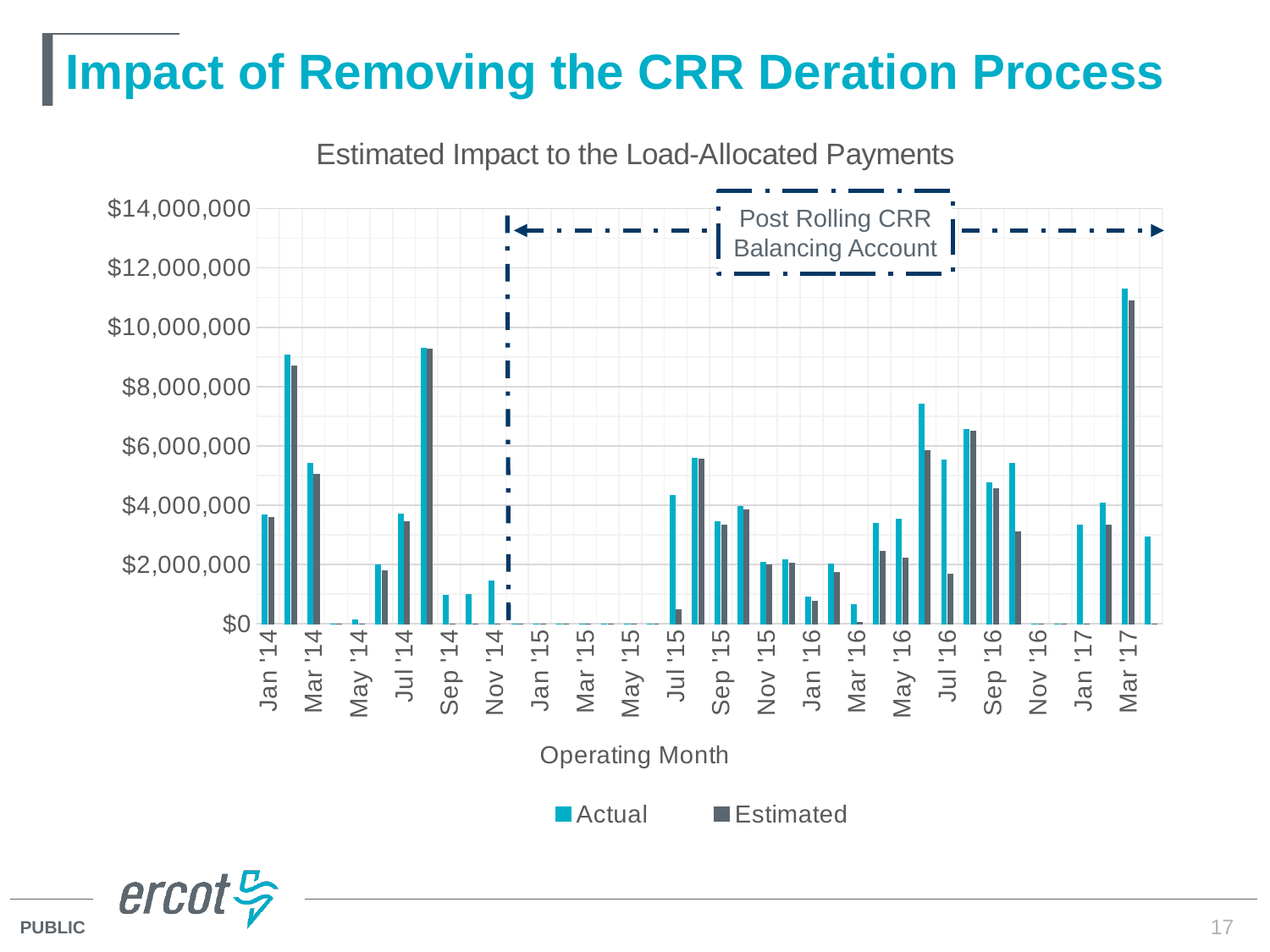
What are the two series named in the legend? Actual and Estimated Is the Actual value for Mar '17 greater or less than $10,000,000? greater What kind of chart is shown on the slide? bar chart How many series does the legend list? 2 Which operating month has the highest Actual value? Mar '17 Is the Actual value for Jul '16 greater or less than $4,000,000? greater Which is larger for Jul '15, the Actual value or the Estimated value? Actual Is the Actual value for Jan '16 greater or less than $2,000,000? less What is the title of the chart? Estimated Impact to the Load-Allocated Payments